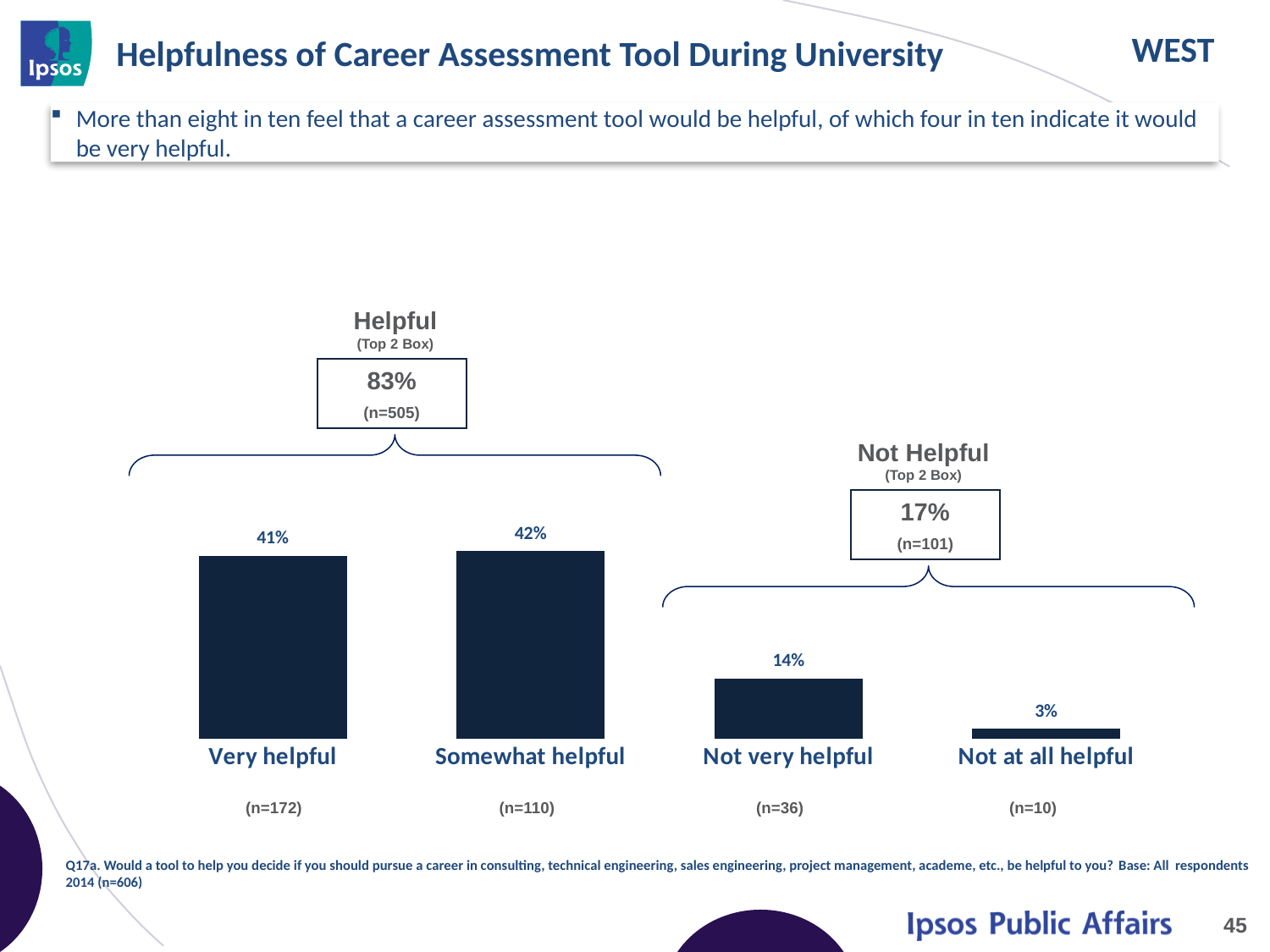
Which is larger, the percentage for 'Very helpful' or for 'Not very helpful'? Very helpful What kind of chart is shown on the slide? Bar chart What is the sample size (n) shown for the 'Very helpful' category? n=172 What percentage of respondents said a career assessment tool would be very helpful? 41% Which response category has the lowest percentage? Not at all helpful What is the Helpful (Top 2 Box) percentage shown on the chart? 83% What percentage of respondents said a career assessment tool would be not at all helpful? 3% What percentage of respondents said a career assessment tool would be not very helpful? 14% What percentage of respondents said a career assessment tool would be somewhat helpful? 42% How many response categories are shown as bars on the chart? 4 What is the Not Helpful (Top 2 Box) percentage shown on the chart? 17% What is the difference in percentage points between 'Not very helpful' and 'Not at all helpful'? 11